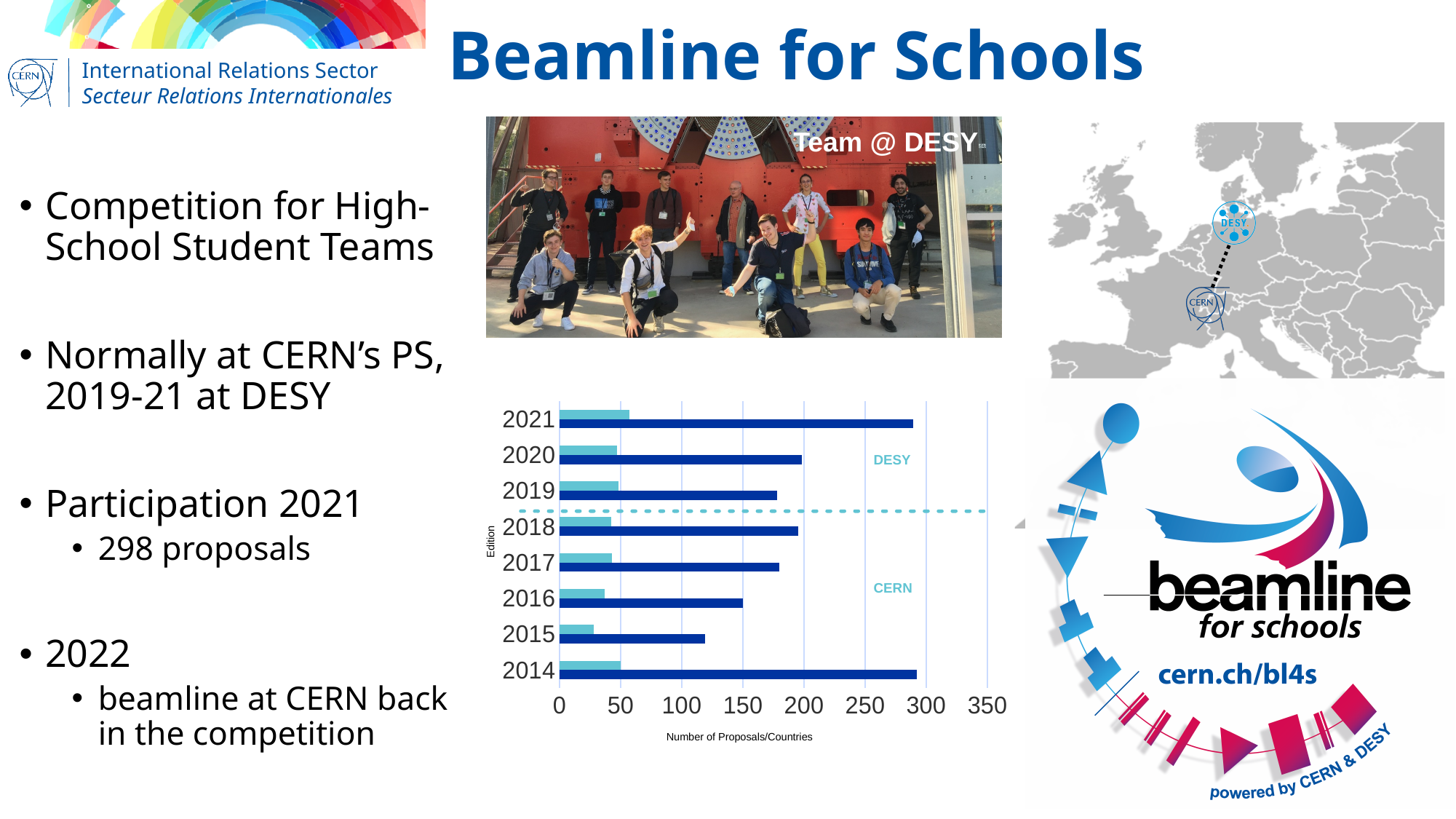
Which edition has the shortest light blue bar in the chart? 2015 Is the dark blue bar for 2021 greater or less than 250? greater Is the dark blue bar for 2020 greater or less than 150? greater Which edition has the shortest dark blue bar in the chart? 2015 Is the dark blue bar for 2015 greater or less than 150? less Which edition has the longer dark blue bar, 2020 or 2016? 2020 Do the dark blue bars rise or fall from the 2015 edition to the 2018 edition? rise What is the label on the x axis of the chart? Number of Proposals/Countries What kind of chart is shown on the slide? bar chart How many editions (years) are listed on the y axis of the chart? 8 Which edition has the longest light blue bar in the chart? 2021